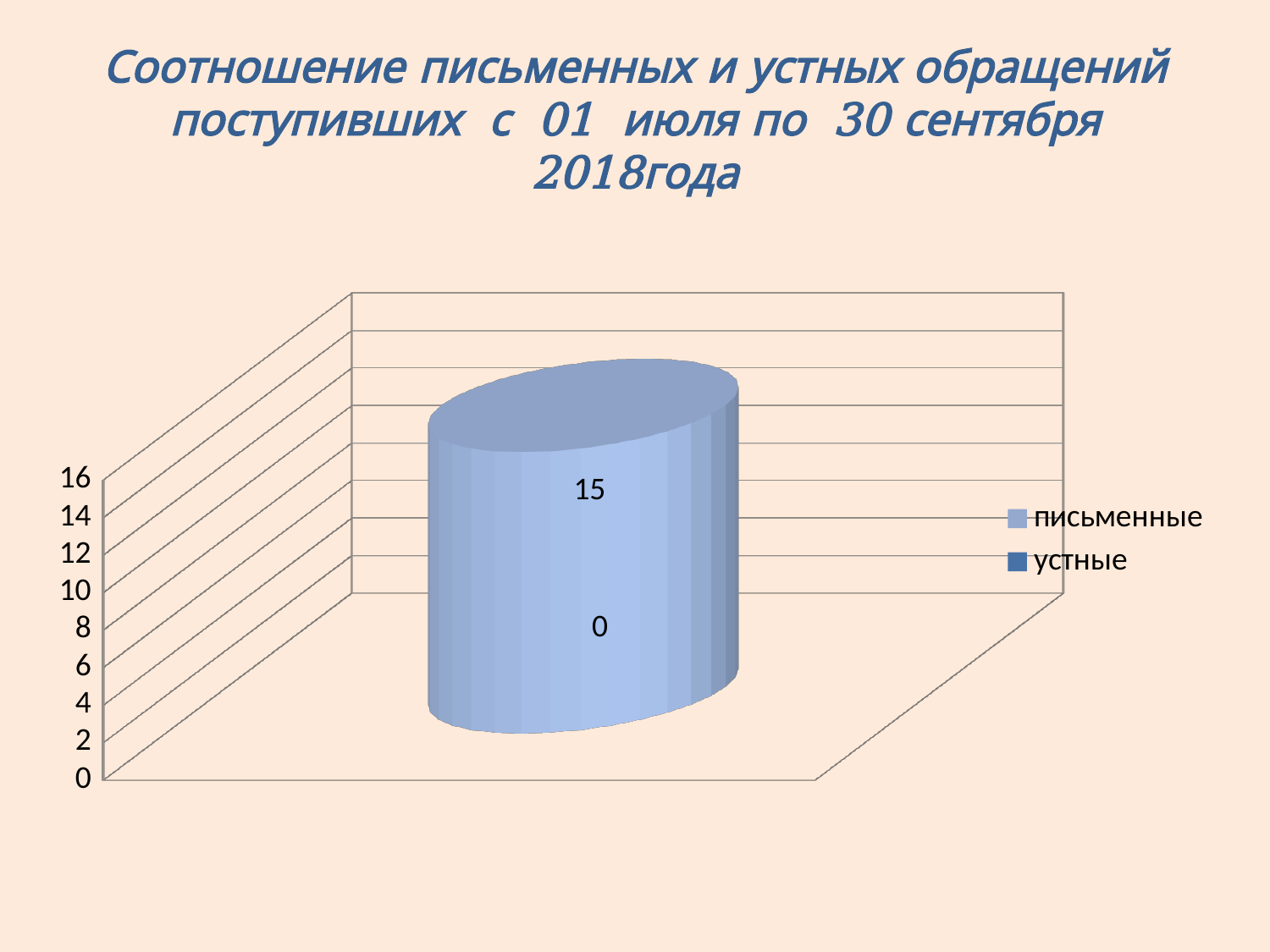
Which series has the lowest value? устные What is the difference between the values for письменные and устные? 15 What is the value for устные? 0 What is the total of the values for письменные and устные? 15 Which series has the highest value? письменные Which series has the higher value, письменные or устные? письменные How many series does the legend list? 2 What is the maximum value shown on the vertical axis? 16 Which legend entry is shown in the darker blue colour? устные What kind of chart is shown on the slide? bar chart Is the value for письменные greater or less than 10? greater What is the value for письменные? 15